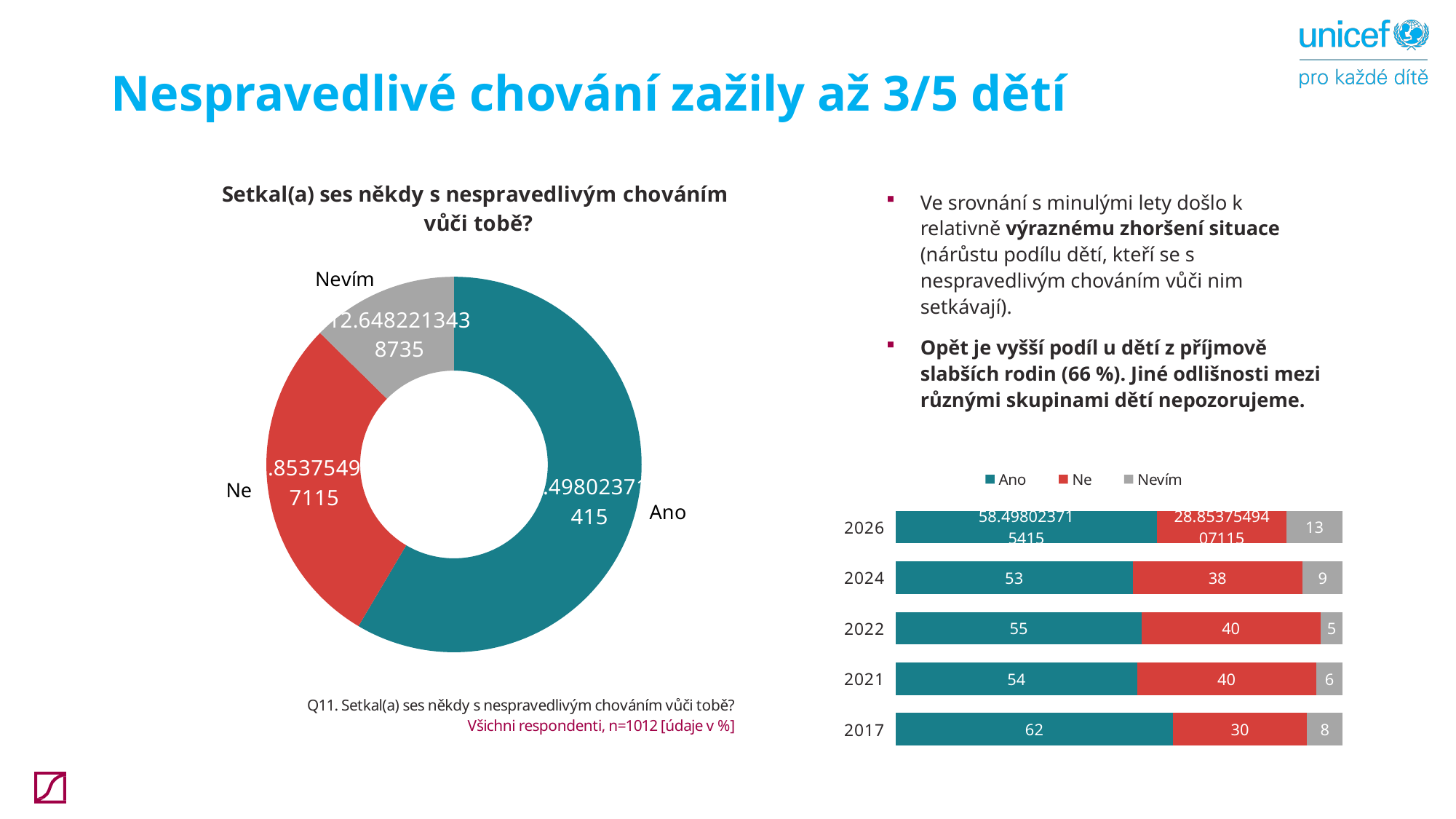
In the bar chart on the right, which year has the highest value for Ano? 2017 In the bar chart on the right, which year has the lowest value for Nevím? 2022 In the pie chart on the left, which slice is the largest? Ano In the bar chart on the right, what is the value for Nevím in 2026? 13 In the bar chart on the right, what is the value for Ne in 2024? 38 What kind of chart is the chart on the right of the slide showing the years 2017 to 2026? bar chart What kind of chart is the chart on the left of the slide, titled "Setkal(a) ses někdy s nespravedlivým chováním vůči tobě?"? doughnut chart In the bar chart on the right, what is the value for Ano in 2017? 62 In the bar chart on the right, what is the total of the stacked bar for 2024? 100 In the bar chart on the right, what is the difference between the Ano value in 2017 and the Ano value in 2024? 9 In the bar chart on the right, how many series does the legend list? 3 In the bar chart on the right, how many years are shown? 5